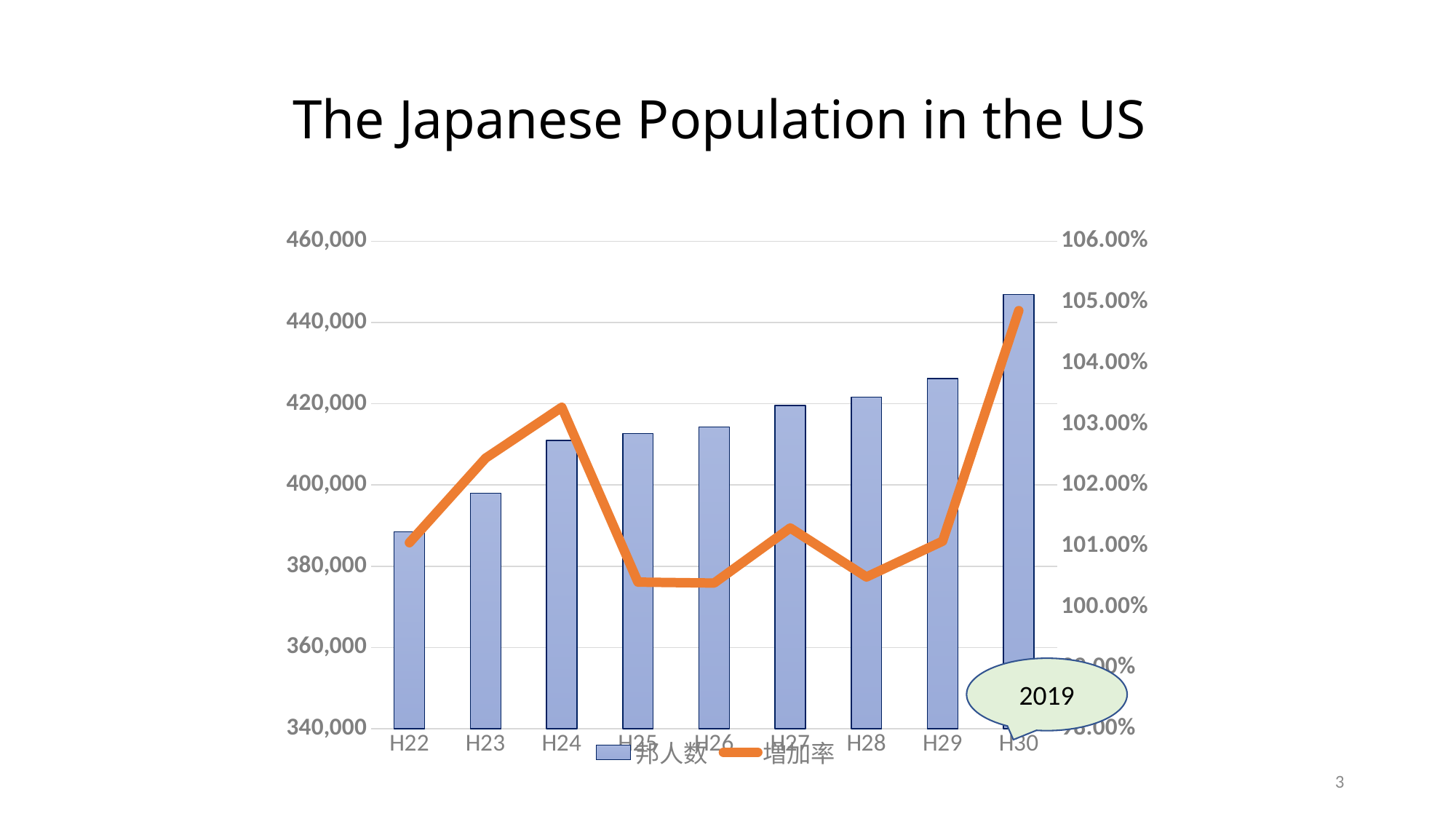
How many categories are shown on the x axis? 9 Is the bar value (邦人数) for H30 greater or less than 440,000? greater What kind of chart is shown on the slide? A combined bar and line chart Is the line value (増加率) for H30 greater or less than 104.00%? greater What is the title of the slide? The Japanese Population in the US Which category has the shortest bar (邦人数)? H22 Do the bar values (邦人数) generally rise or fall from H22 to H30? rise Which category has the tallest bar (邦人数)? H30 Is the bar value (邦人数) for H22 greater or less than 400,000? less How many series does the legend list? 2 Which has the higher line value (増加率), H24 or H25? H24